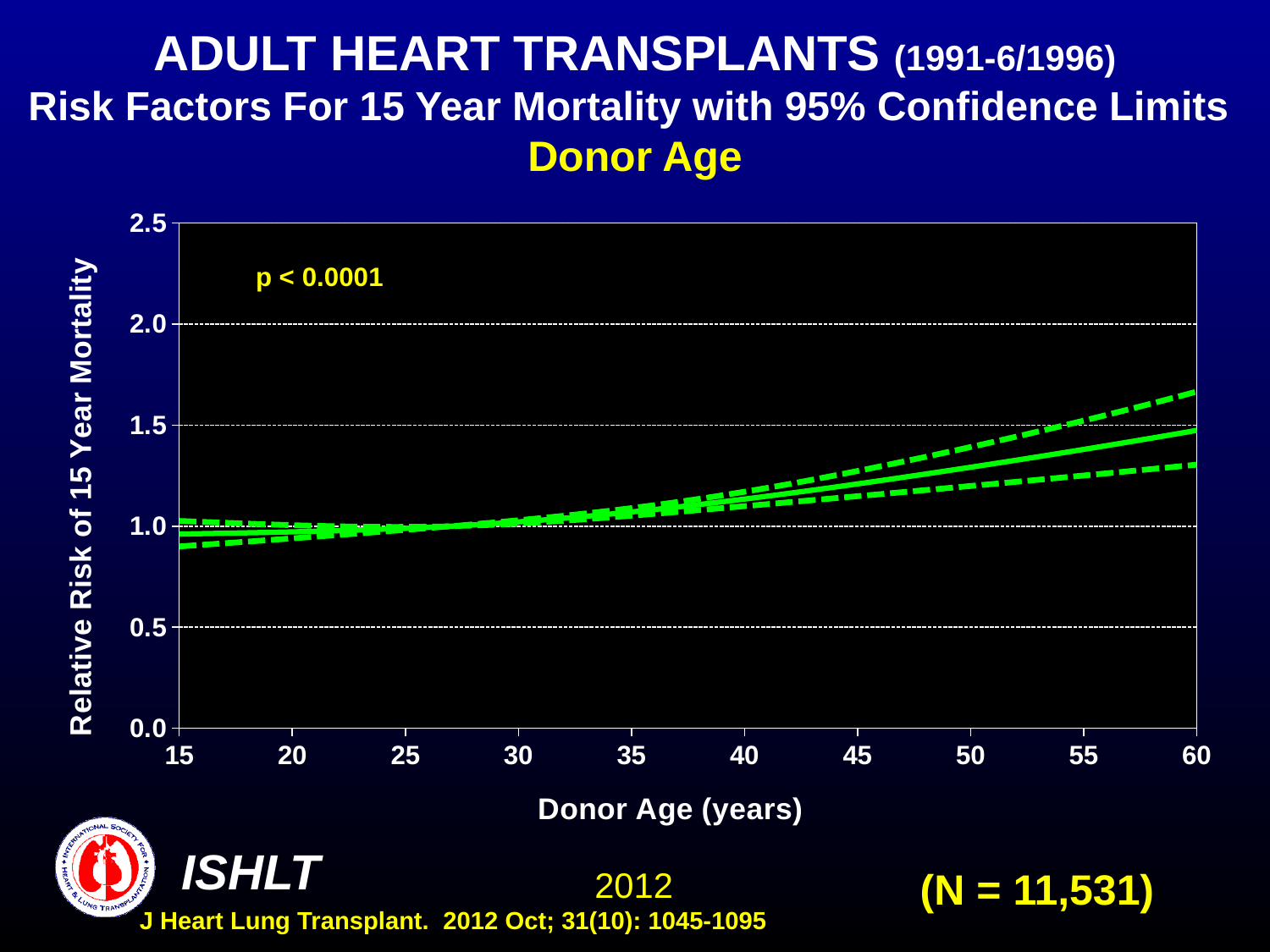
Is the relative risk (solid line) at donor age 45 greater or less than 1.0? greater What kind of chart is shown on the slide? line chart Does the relative risk of 15 year mortality rise or fall as donor age increases from 15 to 60 years? rise Is the relative risk (solid line) at donor age 60 greater or less than 1.0? greater What is the label of the x axis? Donor Age (years) Is the lower 95% confidence limit at donor age 60 greater or less than 1.5? less At which donor age is the relative risk of 15 year mortality (solid line) highest? 60 How many lines are plotted on the chart? 3 What p-value is shown on the chart? p < 0.0001